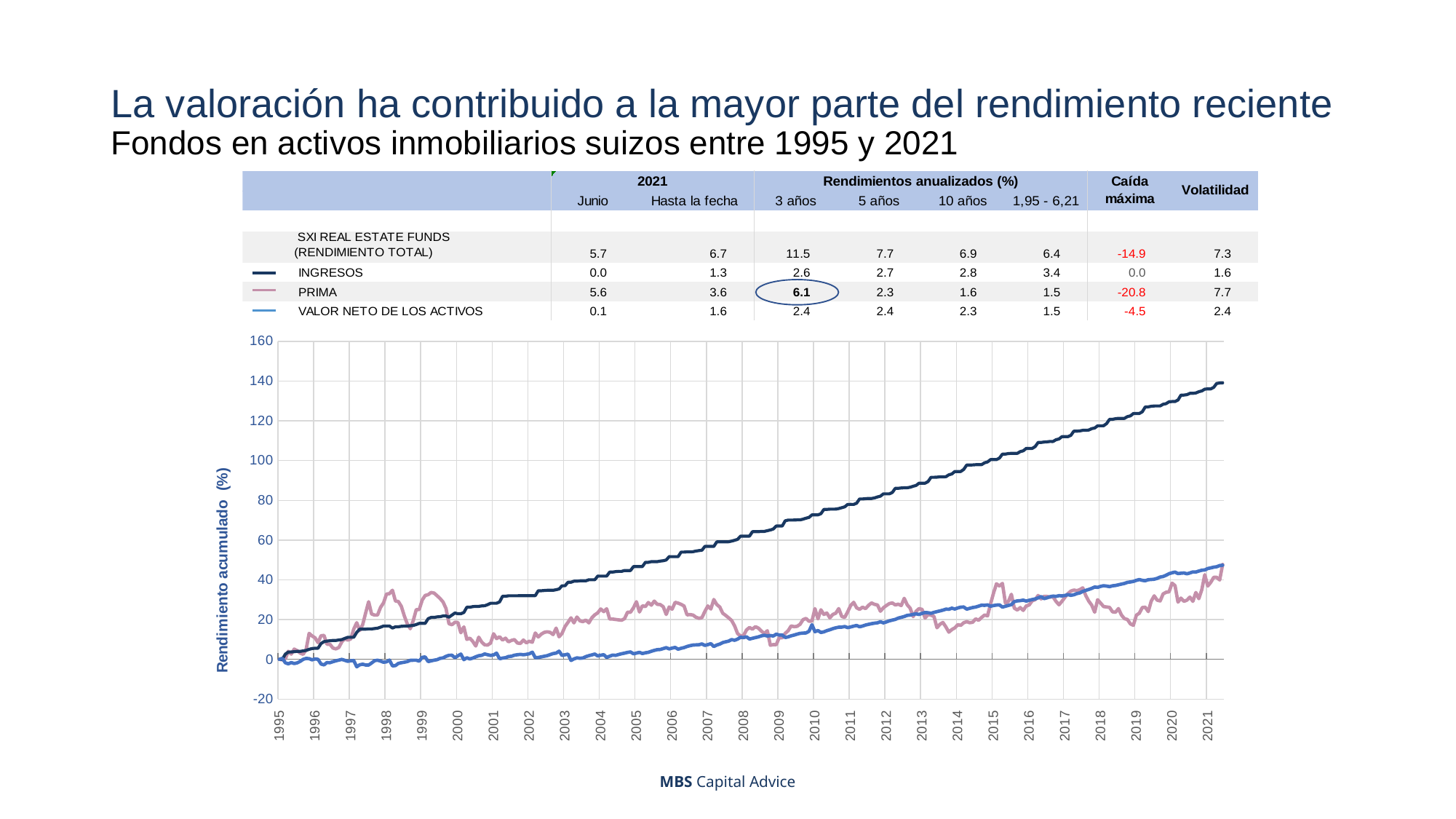
Which series has the highest value in 2021? INGRESOS What kind of chart is shown on the slide? line chart Is the value for VALOR NETO DE LOS ACTIVOS in 2005 greater or less than 20? less Is the value for INGRESOS in 2021 greater or less than 120? greater Which series has the lowest value in 2005? VALOR NETO DE LOS ACTIVOS How many series does the chart's legend list? 3 How many year labels are shown on the x axis? 27 Is the value for PRIMA in 1998 greater or less than 20? greater In 2015, which is larger: INGRESOS or PRIMA? INGRESOS What is the title of the chart's y axis? Rendimiento acumulado (%) Does the INGRESOS line rise or fall from 1995 to 2021? rises